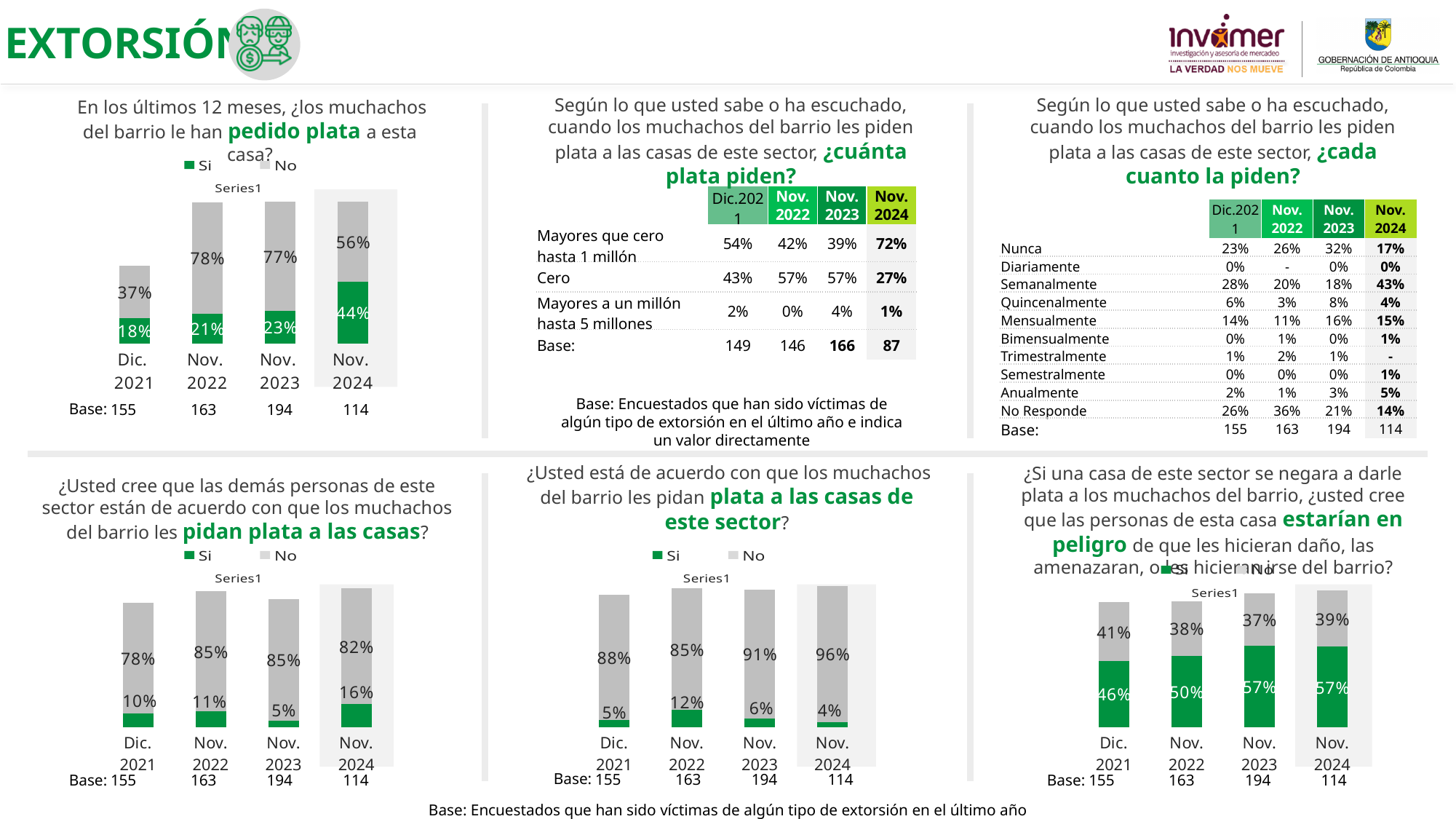
In the top-left chart ("¿los muchachos del barrio le han pedido plata a esta casa?"), which period has the highest Si value? Nov. 2024 In the bottom-left chart ("¿Usted cree que las demás personas de este sector están de acuerdo...?"), which period has the lowest Si value? Nov. 2023 In the bottom-middle chart ("¿Usted está de acuerdo con que los muchachos del barrio les pidan plata...?"), which period has the highest Si value? Nov. 2022 In the top-left chart ("¿los muchachos del barrio le han pedido plata a esta casa?"), what is the value of the Si series for Nov. 2024? 44% What kind of chart is the bottom-middle chart ("¿Usted está de acuerdo con que los muchachos del barrio les pidan plata...?")? Stacked bar chart In the top-left chart ("¿los muchachos del barrio le han pedido plata a esta casa?"), what is the difference between the Si values for Nov. 2024 and Nov. 2023? 21 percentage points In the top-left chart ("¿los muchachos del barrio le han pedido plata a esta casa?"), what is the No value for Nov. 2022? 78% In the bottom-right chart ("¿usted cree que las personas de esta casa estarían en peligro...?"), is the Si value for Nov. 2022 larger or smaller than the No value for Nov. 2022? larger In the bottom-middle chart ("¿Usted está de acuerdo con que los muchachos del barrio les pidan plata...?"), what is the No value for Nov. 2024? 96% How many periods are shown on the x axis of the bottom-right chart ("¿usted cree que las personas de esta casa estarían en peligro...?")? 4 In the bottom-left chart ("¿Usted cree que las demás personas de este sector están de acuerdo...?"), what is the Si value for Nov. 2024? 16% In the bottom-right chart ("¿usted cree que las personas de esta casa estarían en peligro...?"), what is the Si value for Dic. 2021? 46%